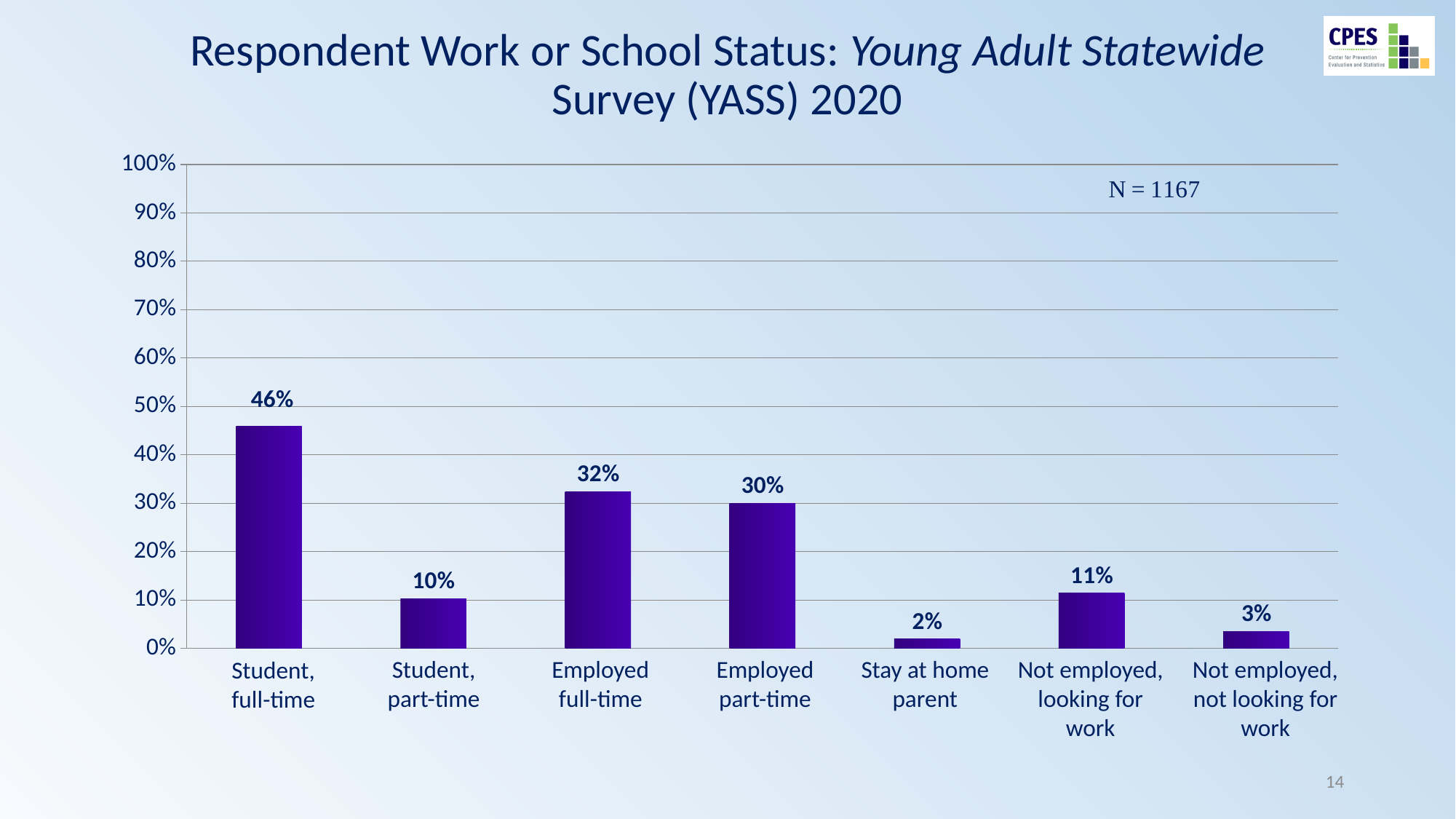
Which is larger: the percentage for Not employed, looking for work or Not employed, not looking for work? Not employed, looking for work What is the sample size (N) shown on the chart? N = 1167 What percentage of respondents are not employed and looking for work? 11% Is the value for Employed full-time greater or less than 40%? less What kind of chart is shown on the slide? Bar chart What percentage of respondents are employed part-time? 30% Which work or school status has the lowest percentage of respondents? Stay at home parent How many work or school status categories are shown on the chart? 7 What is the difference in percentage points between Student, full-time and Student, part-time? 36% What is the difference in percentage points between Employed full-time and Employed part-time? 2% Which work or school status has the highest percentage of respondents? Student, full-time What percentage of respondents are full-time students? 46%